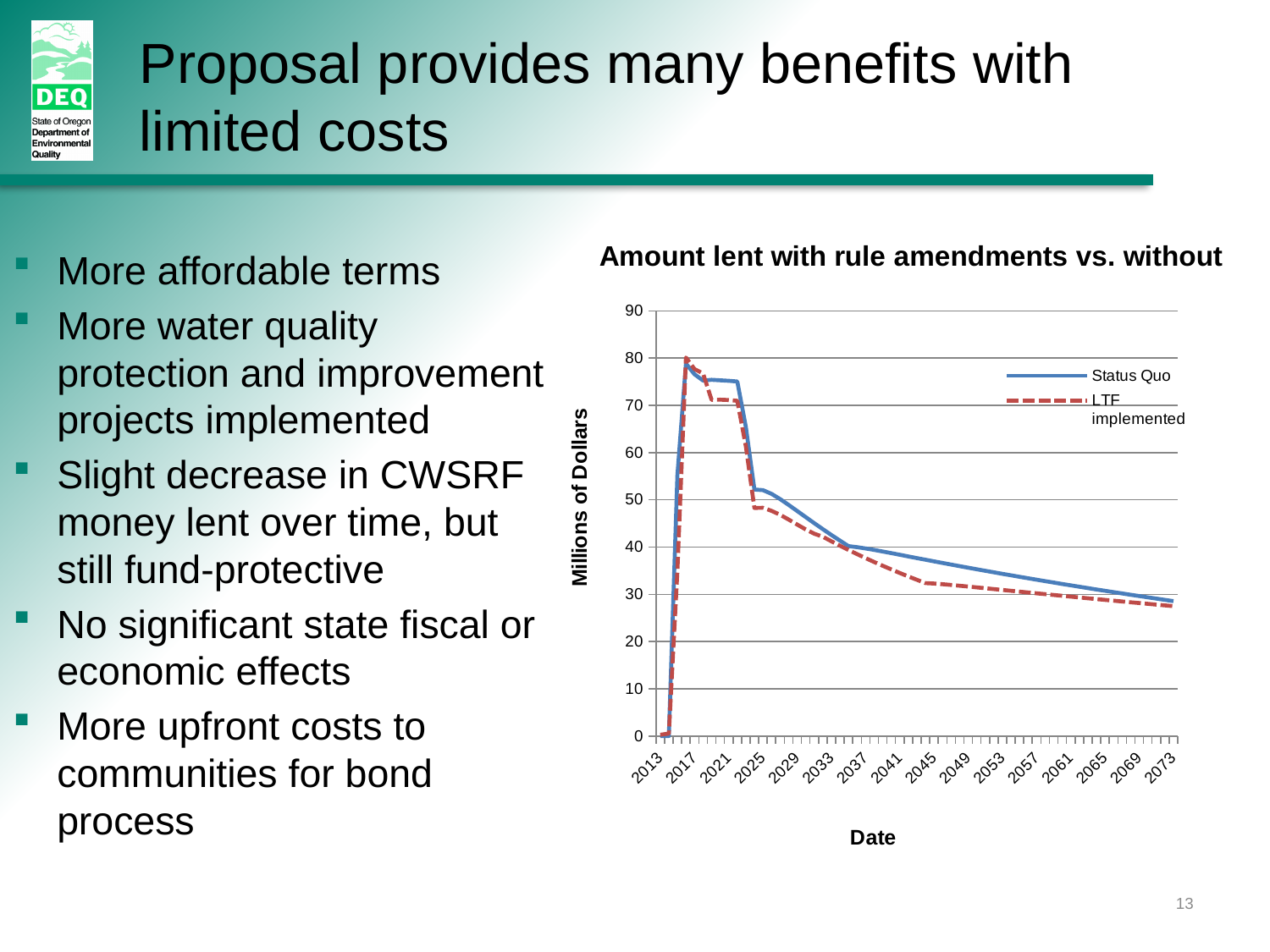
How many year labels are shown on the x axis? 16 In 2045, which series has the higher value, Status Quo or LTF implemented? Status Quo Is the LTF implemented value in 2045 greater or less than 40? less Is the Status Quo value in 2021 greater or less than 70? greater Is the Status Quo value in 2073 greater or less than 40? less From 2025 to 2073, do the Status Quo values rise or fall? fall What is the title of the chart? Amount lent with rule amendments vs. without What is the label of the chart's vertical axis? Millions of Dollars How many series does the chart's legend list? 2 What kind of chart is shown on the slide? line chart